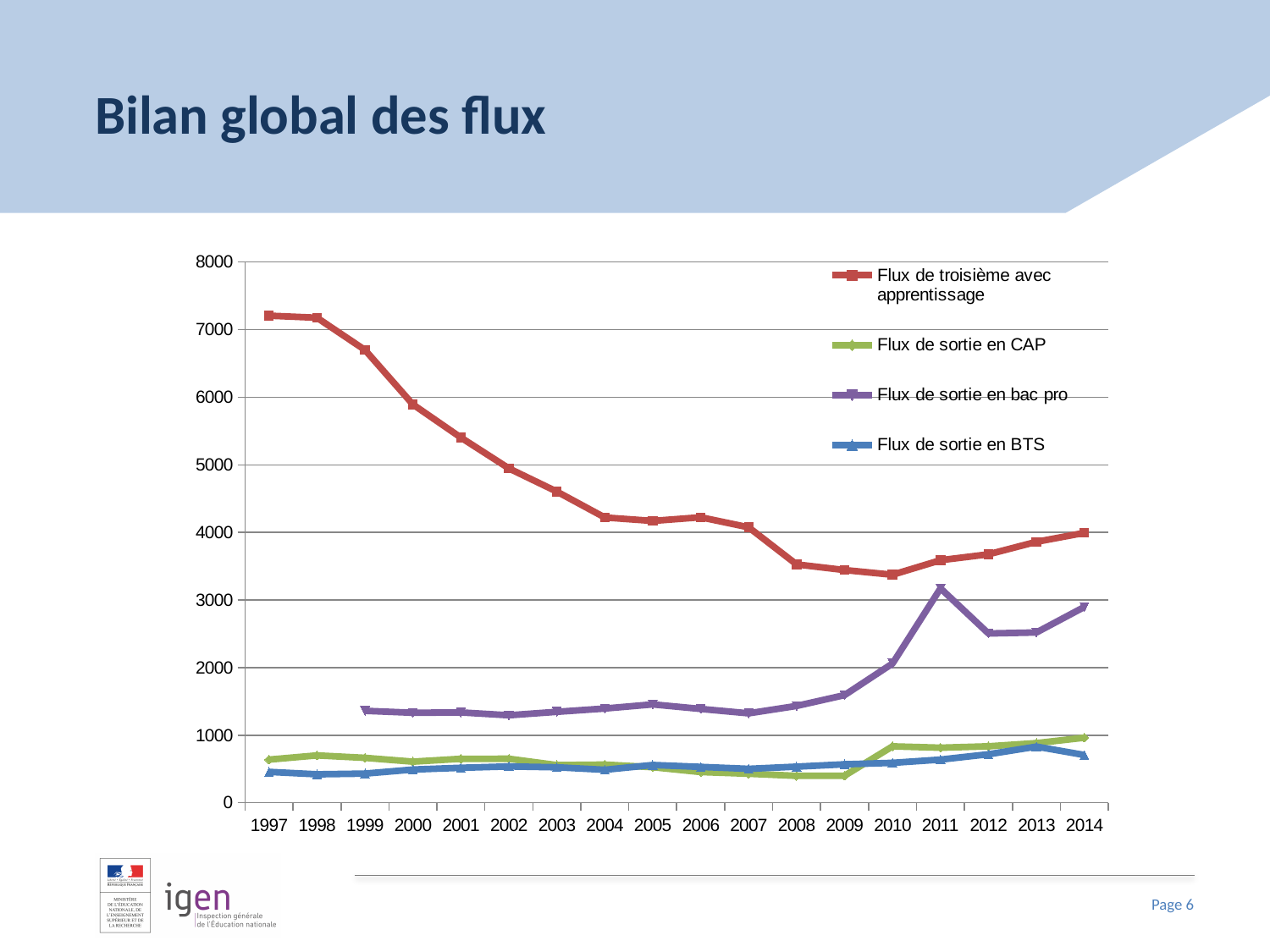
Is the value for Flux de troisième avec apprentissage in 2010 greater or less than 4000? less Is the value for Flux de troisième avec apprentissage in 1997 greater or less than 7000? greater What kind of chart is shown on the slide? Line chart In 2014, which is larger: Flux de sortie en bac pro or Flux de sortie en CAP? Flux de sortie en bac pro How many years are shown on the x axis? 18 Is the value for Flux de sortie en bac pro in 2011 greater or less than 3000? greater In which year does Flux de sortie en bac pro reach its highest value? 2011 How many series does the legend list? 4 Does Flux de troisième avec apprentissage rise or fall from 1997 to 2010? Fall Which series has the lowest value in 1997? Flux de sortie en BTS Which series has the highest values across the whole period? Flux de troisième avec apprentissage